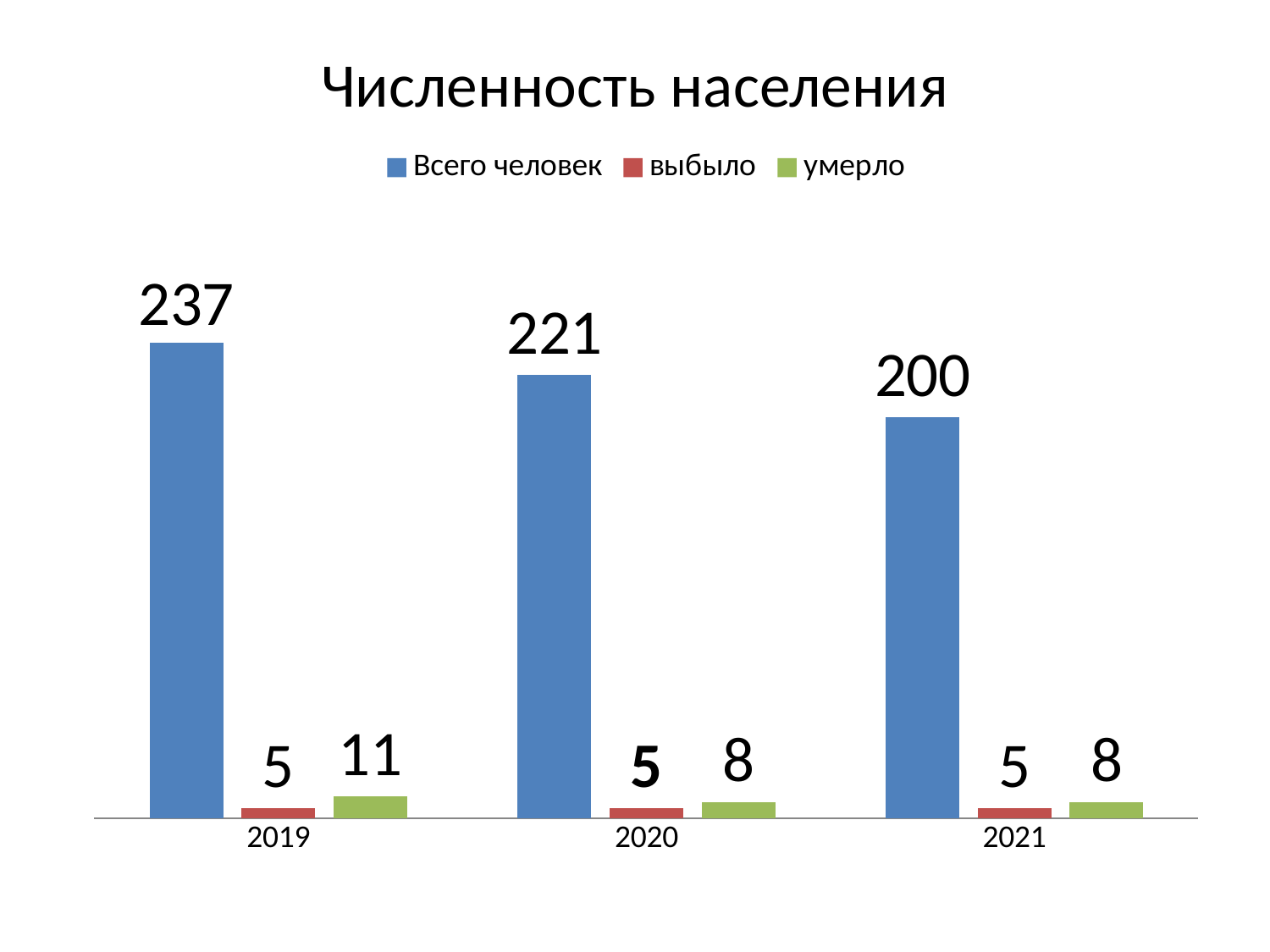
In which year is "Всего человек" the highest? 2019 What is the title of the chart? Численность населения What kind of chart is shown? bar chart What is the value of "Всего человек" for 2019? 237 Does "Всего человек" rise or fall from 2019 to 2021? fall What is the value of "умерло" for 2020? 8 How many years are shown on the x axis? 3 Which is larger: "умерло" in 2019 or "умерло" in 2021? 2019 What is the difference between "Всего человек" in 2019 and 2021? 37 How many series does the legend list? 3 In which year is "умерло" the lowest? 2020 and 2021 What is the value of "выбыло" for 2021? 5